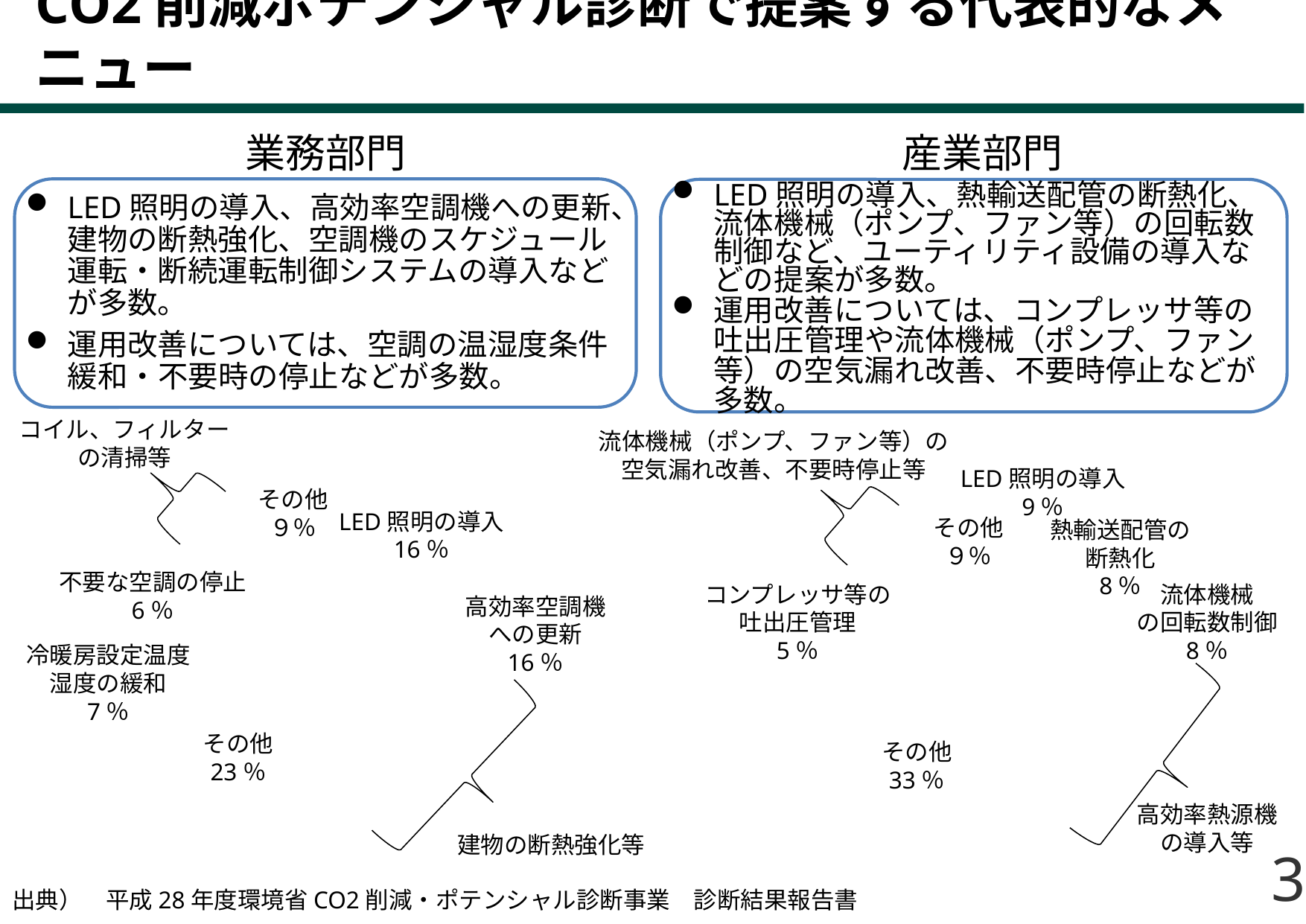
In the 業務部門 chart on the left, what percentage is shown for 不要な空調の停止? 6 % In the 産業部門 chart on the right, what is the larger of the two その他 values shown? 33 % In the 産業部門 chart on the right, which is larger: LED 照明の導入 or コンプレッサ等の吐出圧管理? LED 照明の導入 In the 産業部門 chart on the right, what percentage is shown for 熱輸送配管の断熱化? 8 % In the 業務部門 chart on the left, what percentage is shown for LED 照明の導入? 16 % In the 業務部門 chart on the left, what percentage is shown for 高効率空調機への更新? 16 % In the 業務部門 chart on the left, what is the difference between the LED 照明の導入 value and the 不要な空調の停止 value? 10 % Which chart shows a larger value for LED 照明の導入, the 業務部門 chart or the 産業部門 chart? 業務部門 In the 業務部門 chart on the left, what percentage is shown for 冷暖房設定温度湿度の緩和? 7 % In the 産業部門 chart on the right, what percentage is shown for LED 照明の導入? 9 % In the 業務部門 chart on the left, what is the larger of the two その他 values shown? 23 % In the 産業部門 chart on the right, what percentage is shown for コンプレッサ等の吐出圧管理? 5 %